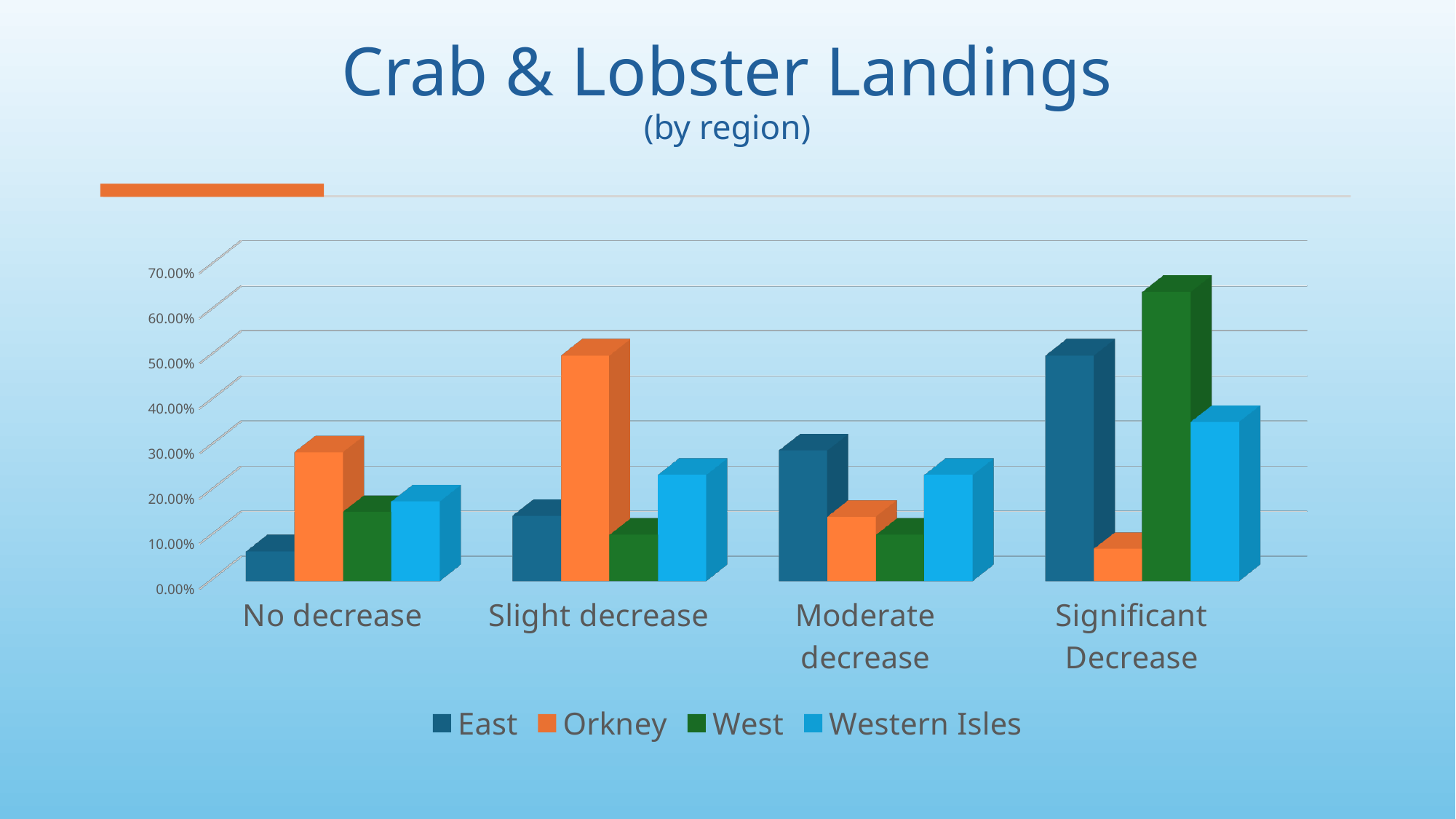
What kind of chart is shown on the slide? bar chart How many categories are shown on the x axis? 4 Is the value for East in the No decrease category greater or less than 10.00%? less Is the value for Orkney in the Slight decrease category greater or less than 40.00%? greater How many series does the legend list? 4 Is the value for West in the Significant Decrease category greater or less than 60.00%? greater Which region has the lowest bar in the Significant Decrease category? Orkney Which region has the highest bar in the No decrease category? Orkney What is the subtitle shown under the chart title? (by region) Which is larger for Orkney: the Slight decrease bar or the No decrease bar? Slight decrease Which region has the highest bar in the Moderate decrease category? East Which region has the highest bar in the Significant Decrease category? West